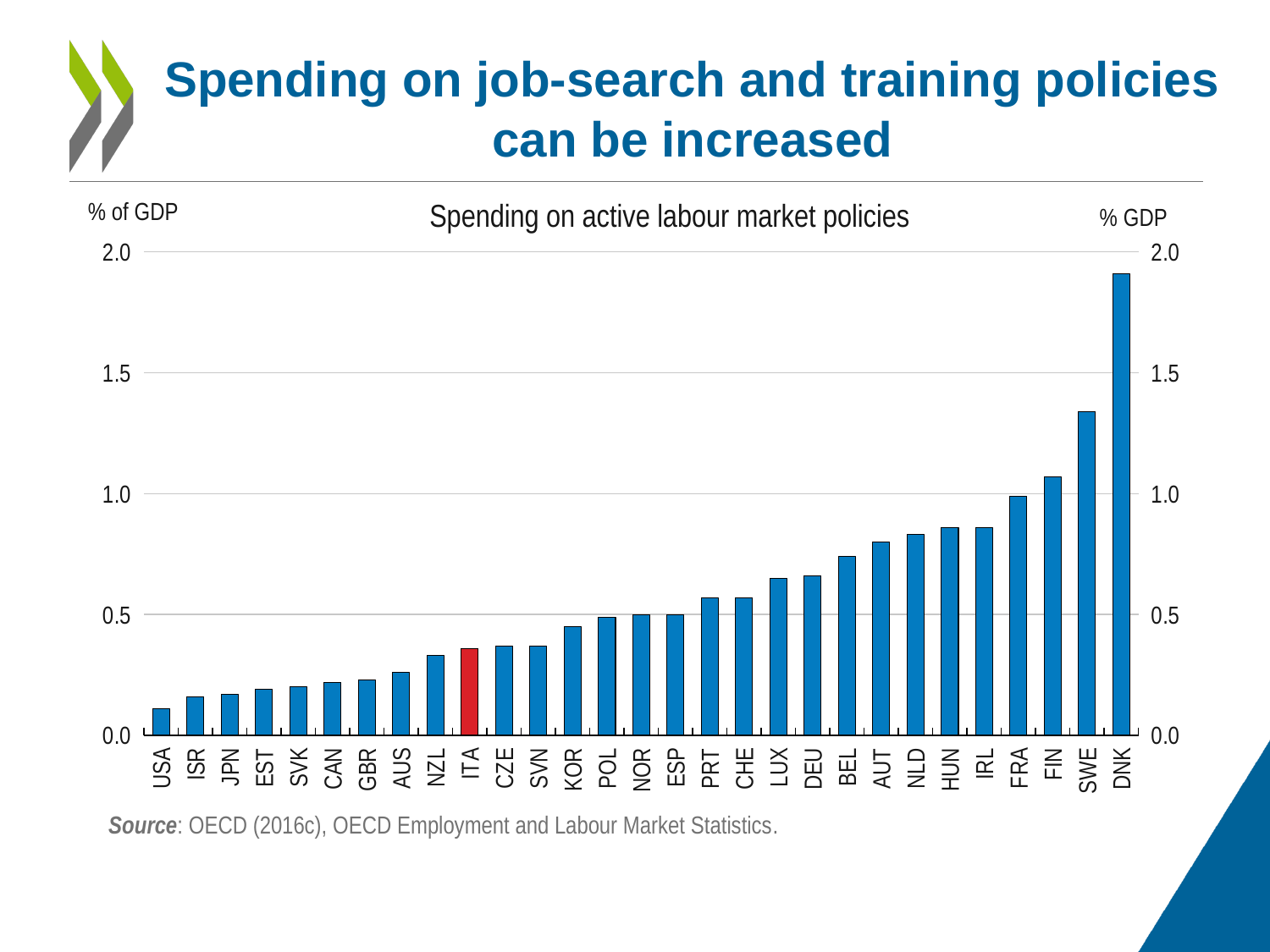
Is the value for LUX greater or less than 0.5? greater Do the values rise or fall moving from left to right along the x axis? rise What kind of chart is shown on the slide? bar chart Which has a higher value, ITA or FRA? FRA Which country has the lowest spending on active labour market policies? USA Which country has the highest spending on active labour market policies? DNK How many countries are shown on the x axis of the chart? 29 Is the value for SWE greater or less than 1.0? greater Is the value for DNK greater or less than 1.5? greater Which has a higher value, SWE or DNK? DNK Which country's bar is highlighted in red? ITA